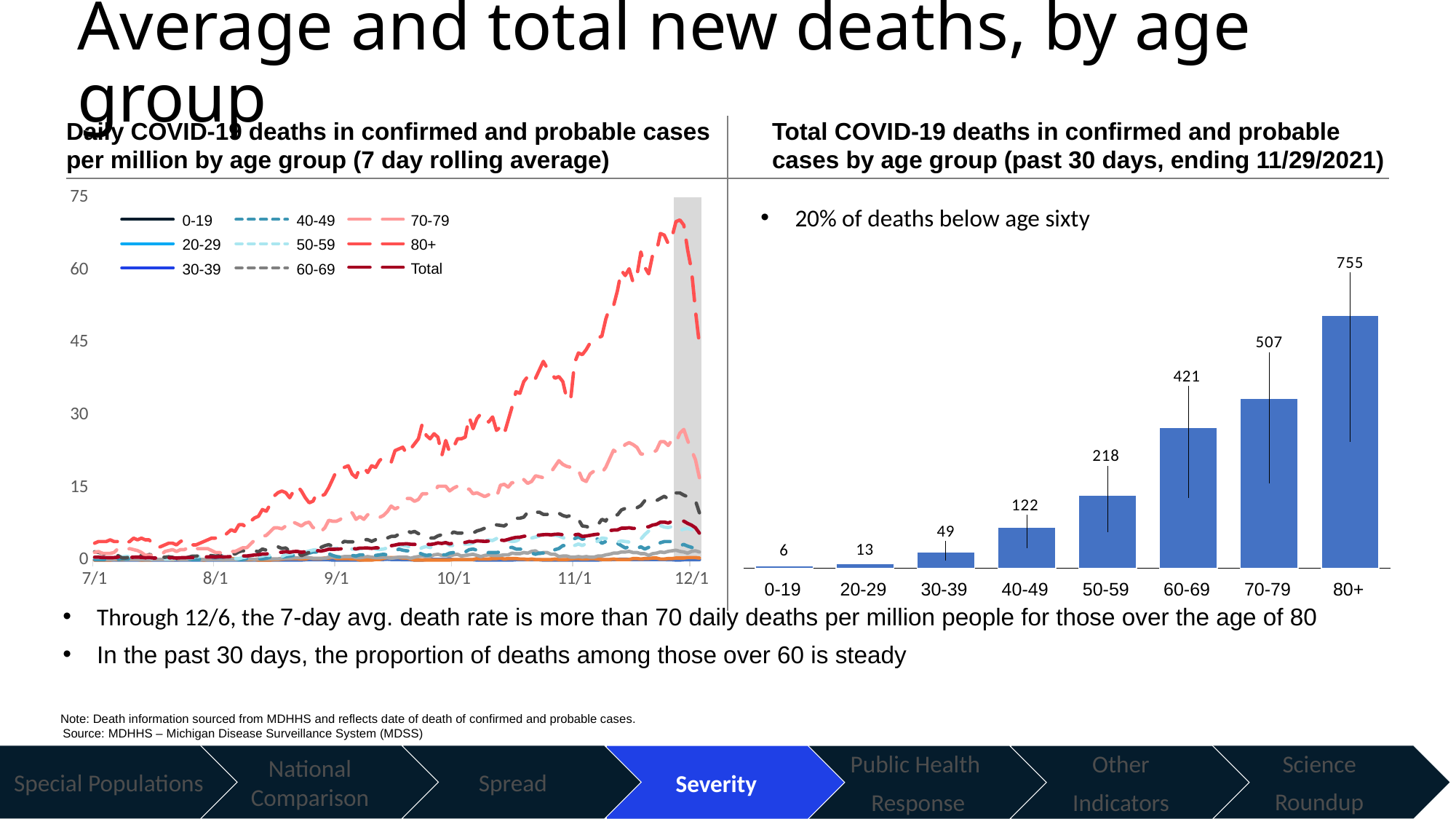
In the bar chart on the right, which age group has the lowest number of deaths? 0-19 In the bar chart on the right, what is the difference between the 80+ and 70-79 values? 248 In the bar chart on the right, what is the difference between the 60-69 and 50-59 values? 203 In the bar chart on the right, how many total COVID-19 deaths are shown for the 80+ age group? 755 In the bar chart on the right, what is the value for the 50-59 age group? 218 In the line chart on the left, does the 80+ line generally rise or fall from 7/1 to 12/1? Rise In the line chart on the left, is the peak value of the 80+ line greater or less than 60? greater In the bar chart on the right, which is larger: the value for 60-69 or for 70-79? 70-79 How many age group categories are shown in the bar chart on the right? 8 What kind of chart is the chart on the right of the slide? Bar chart In the bar chart on the right, which age group has the highest number of deaths? 80+ How many series does the legend of the line chart on the left list? 9